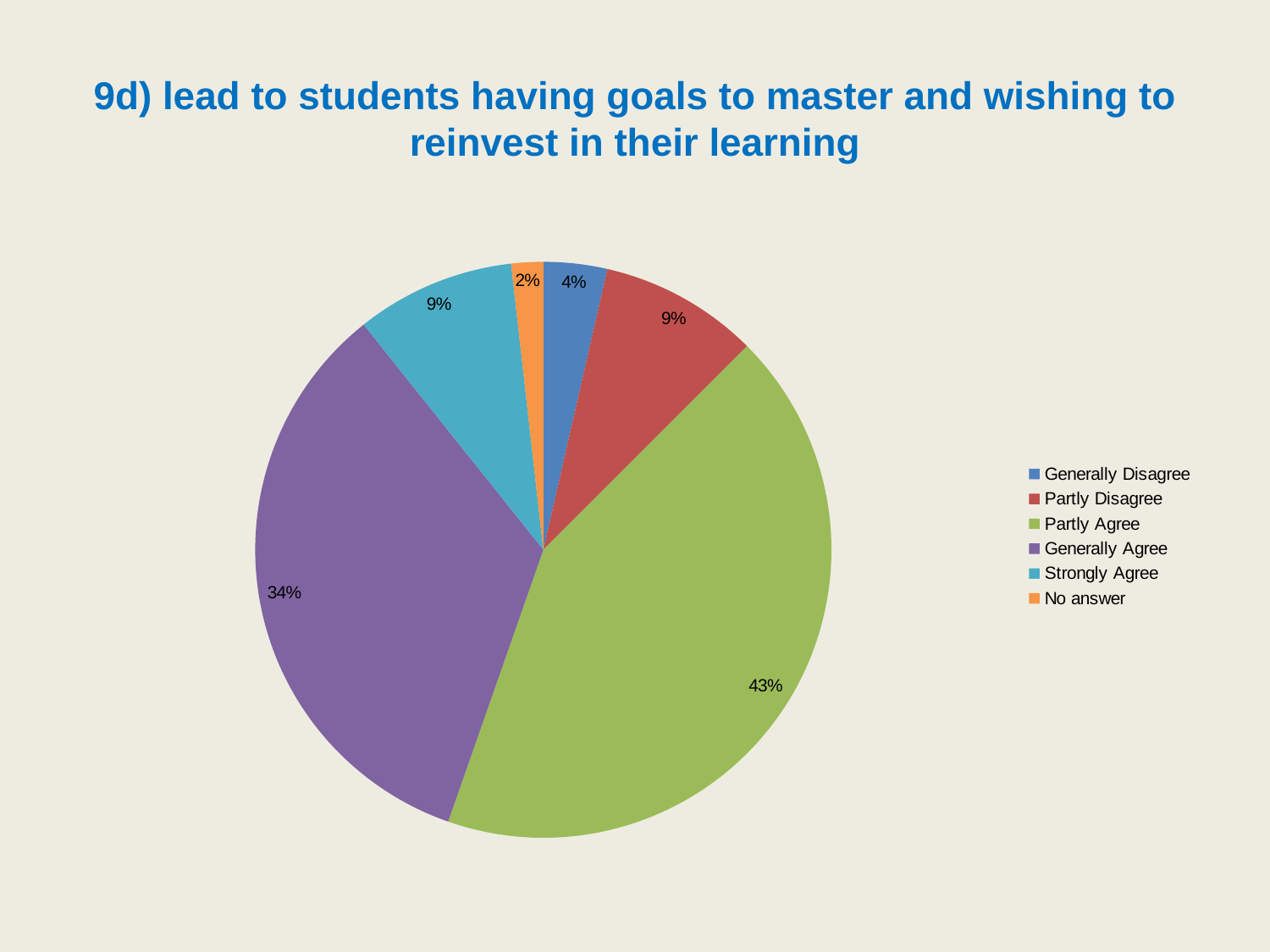
What percentage of respondents chose Generally Agree? 34% How many categories does the legend list? 6 What percentage of respondents chose Generally Disagree? 4% Which is larger, the share for Generally Agree or the share for Strongly Agree? Generally Agree What percentage of respondents chose Partly Agree? 43% Which response category has the largest share of the pie? Partly Agree What percentage of respondents gave No answer? 2% Which response category has the smallest share of the pie? No answer What is the difference in percentage points between Partly Agree and Generally Agree? 9 What kind of chart is shown on the slide? pie chart What is the combined share of Partly Agree and Generally Agree? 77% What colour is the Partly Agree slice? green